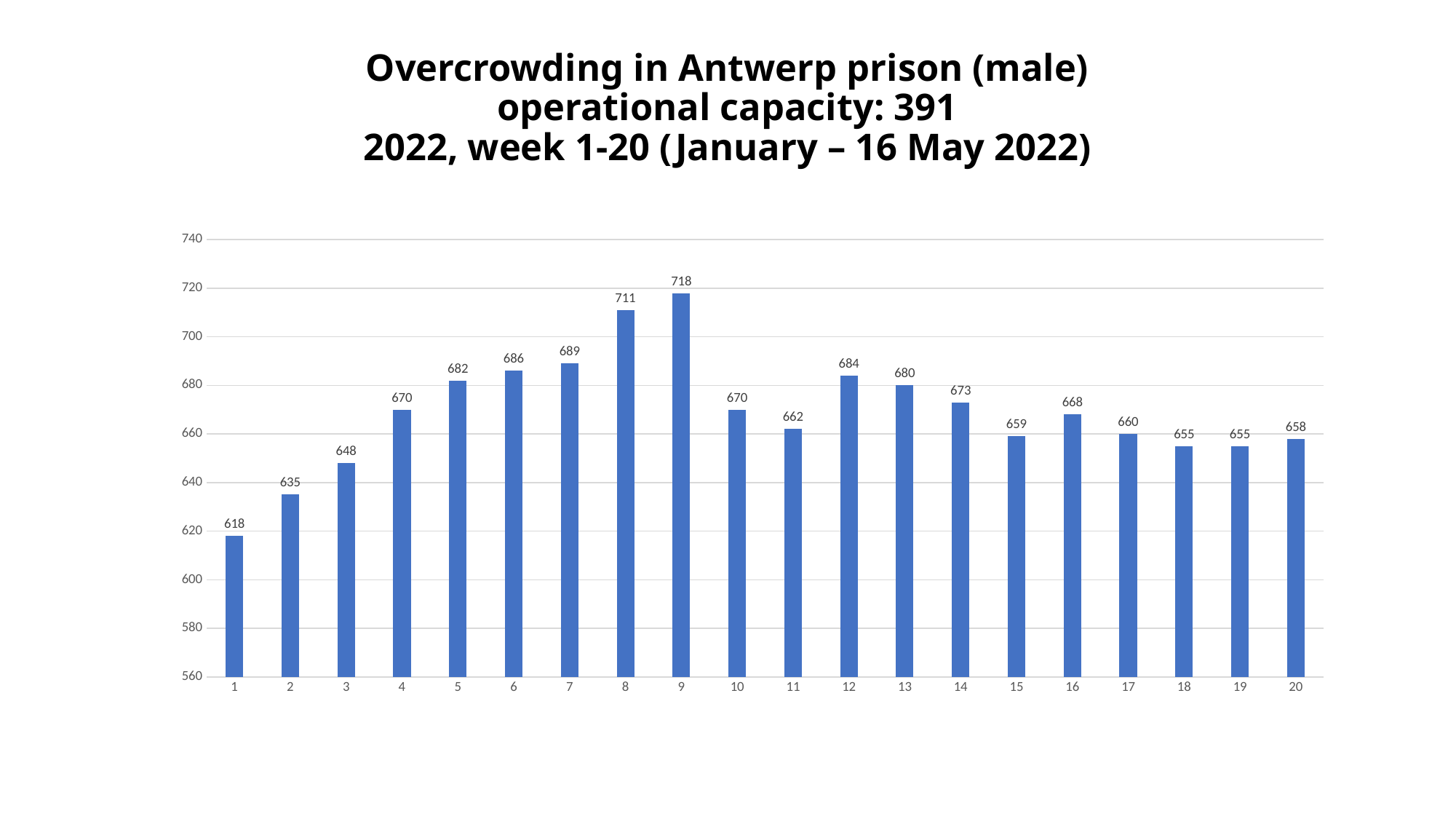
Which week has the lowest value? 1 What is the difference between the values for week 8 and week 10? 41 How many weeks are shown on the x axis? 20 What is the difference between the values for week 9 and week 1? 100 Which week has the highest value? 9 What is the value for week 9? 718 Which is larger, the value for week 5 or the value for week 13? week 5 Is the value for week 3 greater or less than 660? less What is the value for week 1? 618 What is the value for week 14? 673 What kind of chart is shown on the slide? bar chart What operational capacity is stated in the chart title? 391